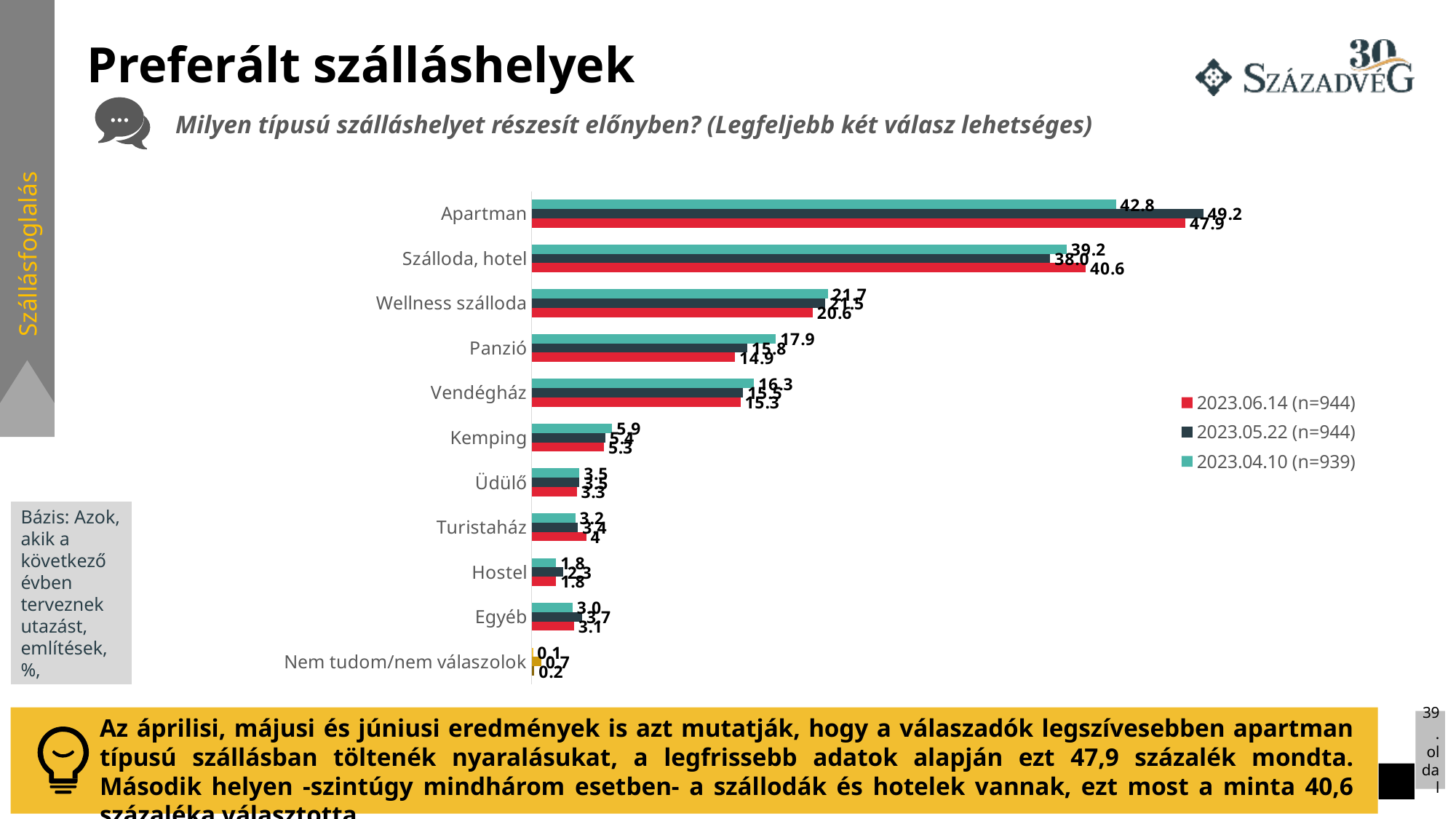
For Szálloda, hotel, which series has the larger value: 2023.06.14 (n=944) or 2023.05.22 (n=944)? 2023.06.14 (n=944) What is the value for Apartman in the 2023.06.14 (n=944) series? 47.9 What is the value for Szálloda, hotel in the 2023.06.14 (n=944) series? 40.6 What is the difference between the 2023.04.10 and 2023.06.14 values for Panzió? 3.0 What is the difference between the 2023.06.14 and 2023.04.10 values for Apartman? 5.1 Which category has the lowest value in the 2023.06.14 (n=944) series? Nem tudom/nem válaszolok How many series does the legend list? 3 What is the value for Panzió in the 2023.04.10 (n=939) series? 17.9 What type of chart is shown on the slide? bar chart How many accommodation categories are shown on the chart? 11 Which category has the highest value in the 2023.06.14 (n=944) series? Apartman What is the value for Apartman in the 2023.05.22 (n=944) series? 49.2